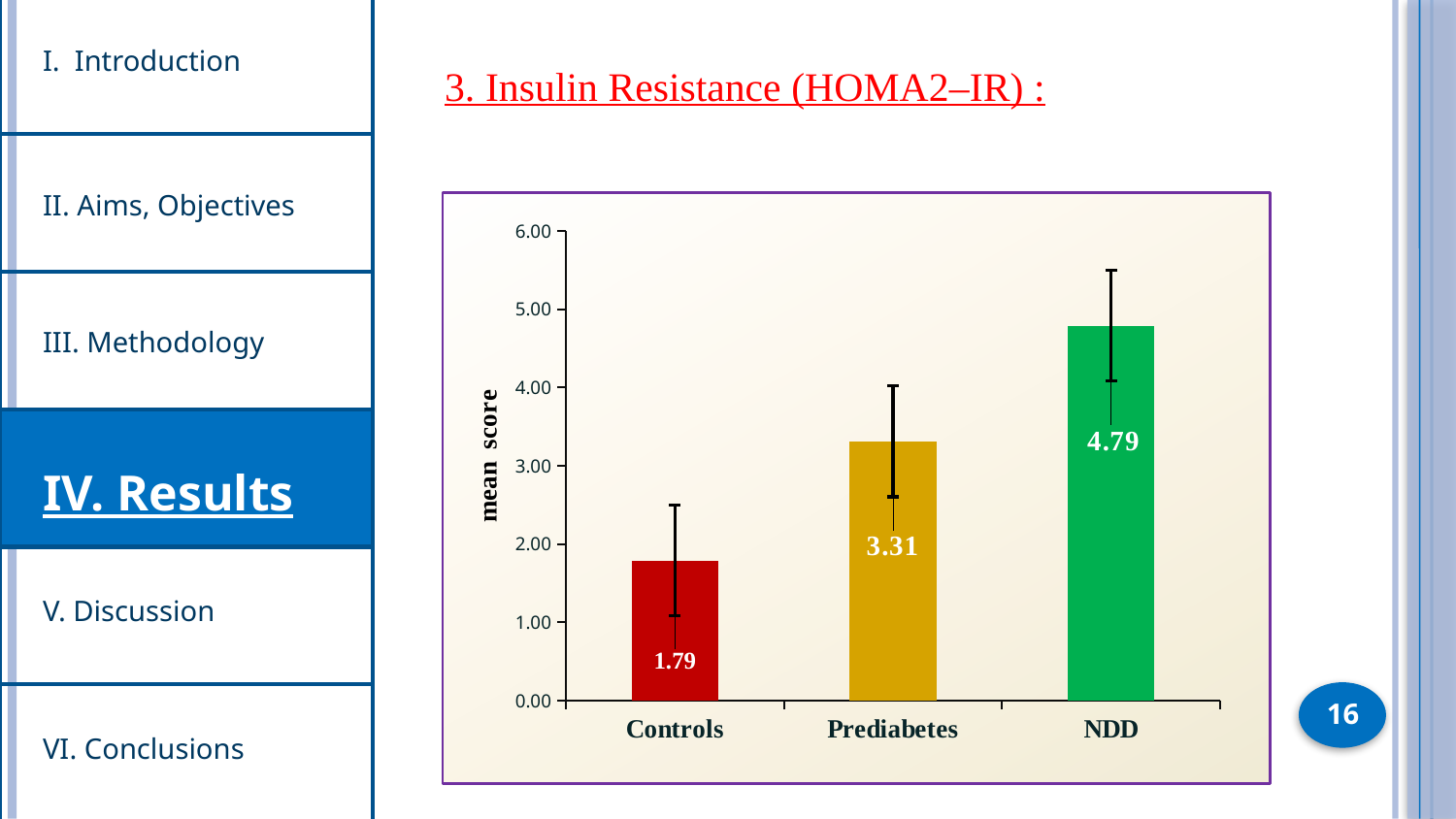
Which group has the highest mean score? NDD What kind of chart is shown on the slide? bar chart What is the mean score for NDD? 4.79 What is the difference in mean score between Prediabetes and Controls? 1.52 What is the difference in mean score between NDD and Controls? 3.00 What is the mean score for Prediabetes? 3.31 Do the mean scores rise or fall from Controls to NDD? rise How many groups are shown on the x axis? 3 Is the mean score for Prediabetes greater or less than 3.00? greater Which group has the lowest mean score? Controls What is the mean score for Controls? 1.79 Which has a larger mean score, Prediabetes or NDD? NDD